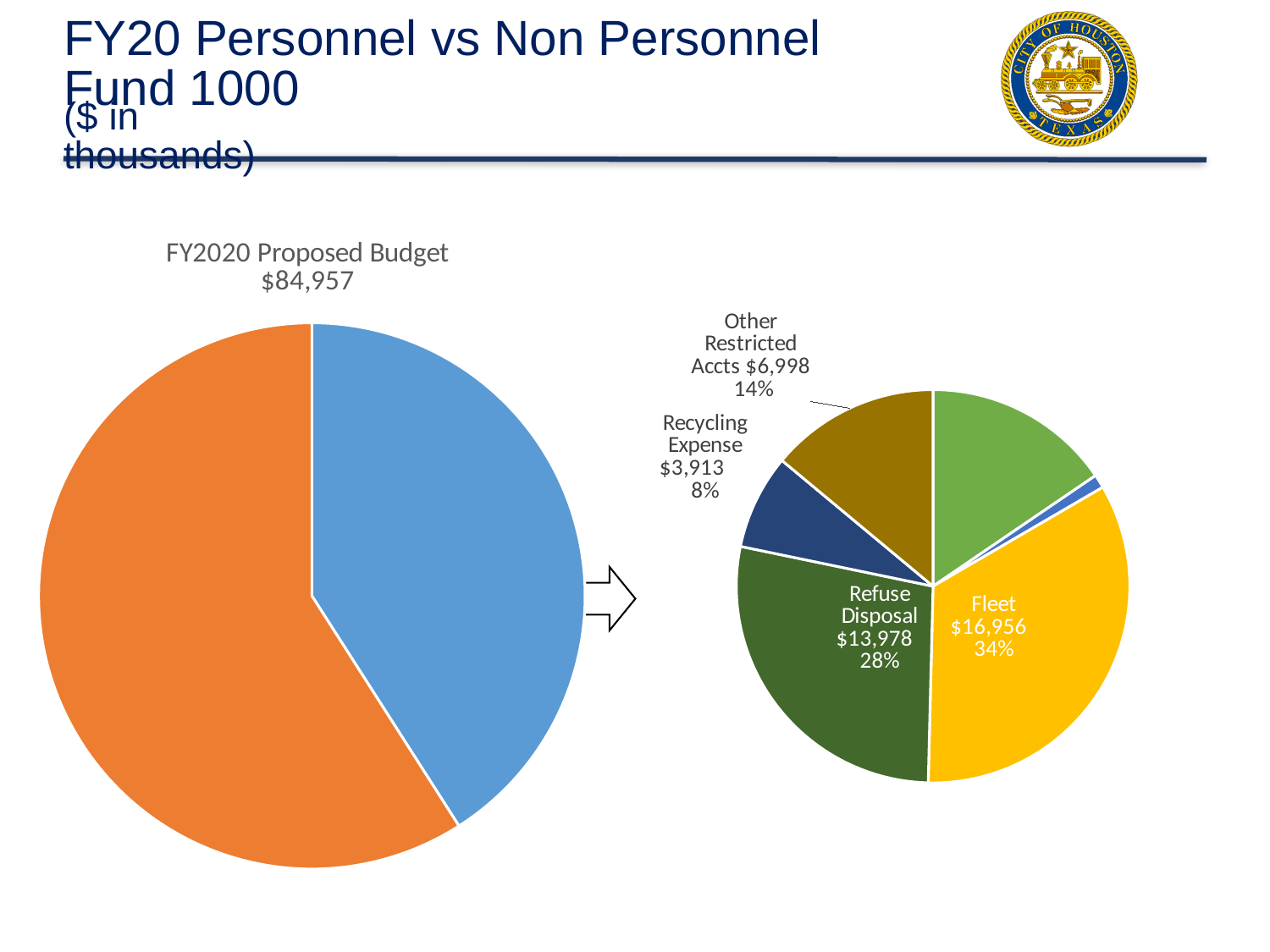
In the pie chart on the right, what share of the pie is Other Restricted Accts? 14% In the pie chart on the right, what share of the pie is Fleet? 34% In the pie chart on the right, what is the value for Recycling Expense? $3,913 In the pie chart on the right, which labeled category has the largest value? Fleet In the pie chart on the right, what is the difference between the Fleet value and the Refuse Disposal value? $2,978 In the pie chart on the left, how many slices are there? 2 What kind of chart is the chart on the left of the slide? Pie chart In the pie chart on the right, which is larger, Other Restricted Accts or Recycling Expense? Other Restricted Accts In the pie chart on the right, what is the value for Fleet? $16,956 In the pie chart on the left, which slice is larger, the orange one or the blue one? Orange In the pie chart on the right, what is the value for Refuse Disposal? $13,978 What is the title of the pie chart on the left of the slide? FY2020 Proposed Budget $84,957